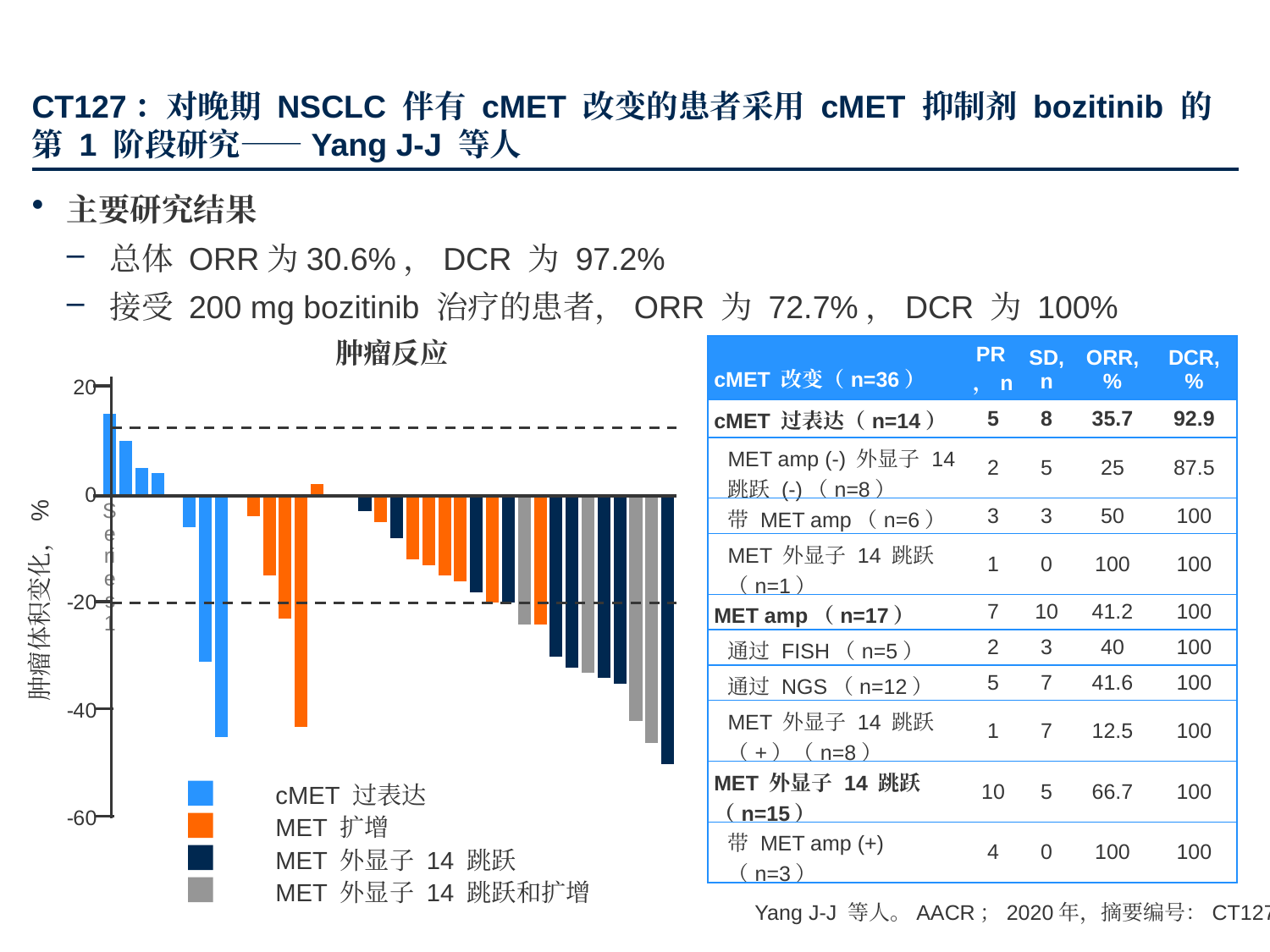
In the 肿瘤反应 chart, which legend group does the highest bar belong to? cMET 过表达 What is the lowest tick value shown on the y axis of the 肿瘤反应 chart? -60 How many entries does the legend of the 肿瘤反应 chart list? 4 What is the title of the chart on the left of the slide? 肿瘤反应 In the 肿瘤反应 chart, do the bar values rise or fall from left to right along the x axis? fall In the 肿瘤反应 chart, is the value of the first (leftmost) bar greater or less than 0? greater In the 肿瘤反应 chart, which legend group does the lowest bar belong to? MET 外显子 14 跳跃 In the 肿瘤反应 chart, is the value of the tallest positive bar greater or less than 10? greater What kind of chart is shown under the title 肿瘤反应? bar chart What is the label of the y axis of the 肿瘤反应 chart? 肿瘤体积变化, % In the 肿瘤反应 chart, is the value of the lowest bar greater or less than -40? less